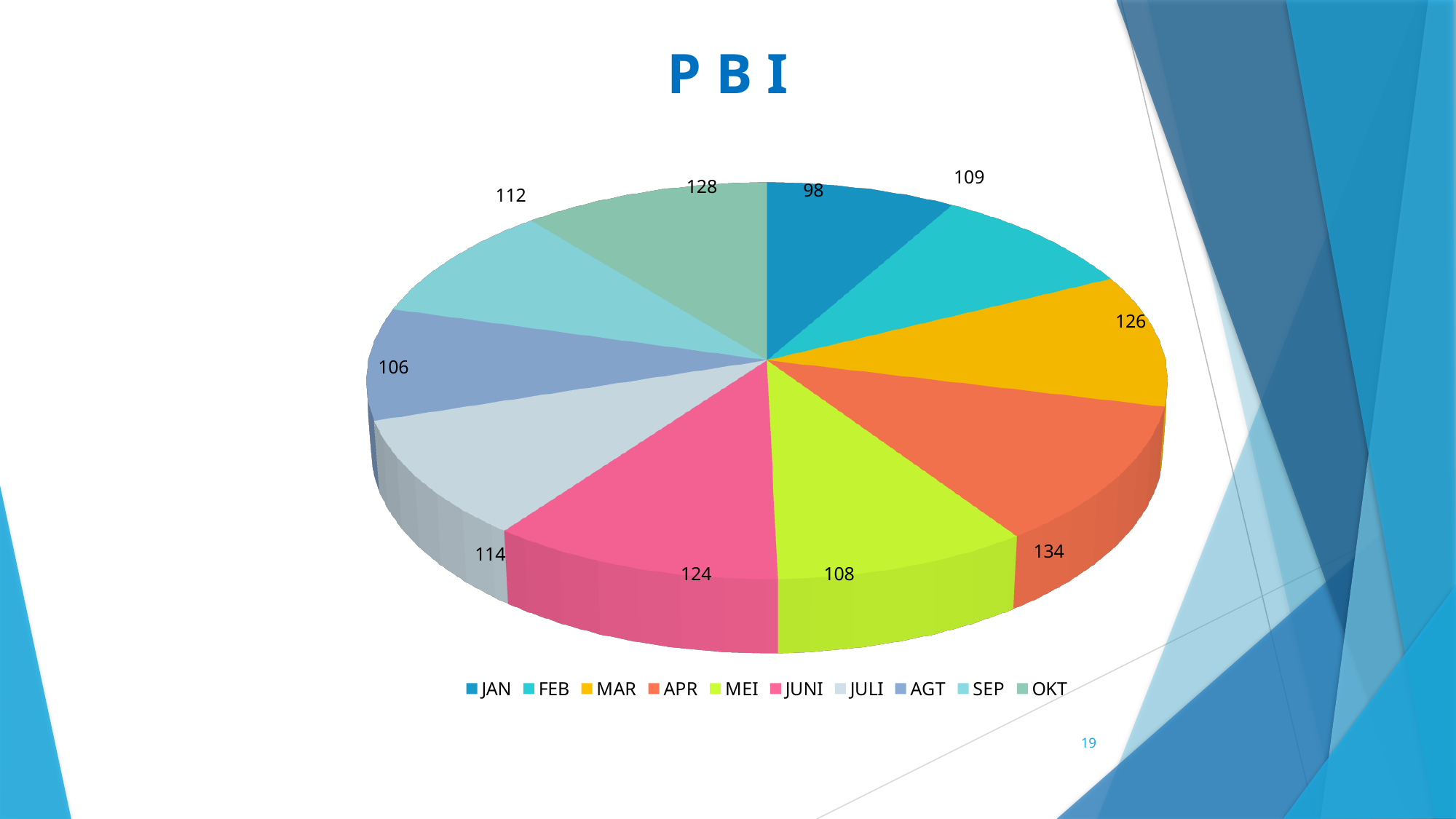
What is the title of the chart? P B I Which month has the lowest value? JAN What is the value for JULI? 114 What type of chart is shown on the slide? pie chart How many categories does the pie chart have? 10 What is the value for JAN? 98 Which month is shown in the legend immediately after MEI? JUNI What is the value for OKT? 128 What is the difference between the values for APR and JAN? 36 Which month has the highest value? APR Which is larger, the value for MAR or the value for OKT? OKT What is the value for APR? 134